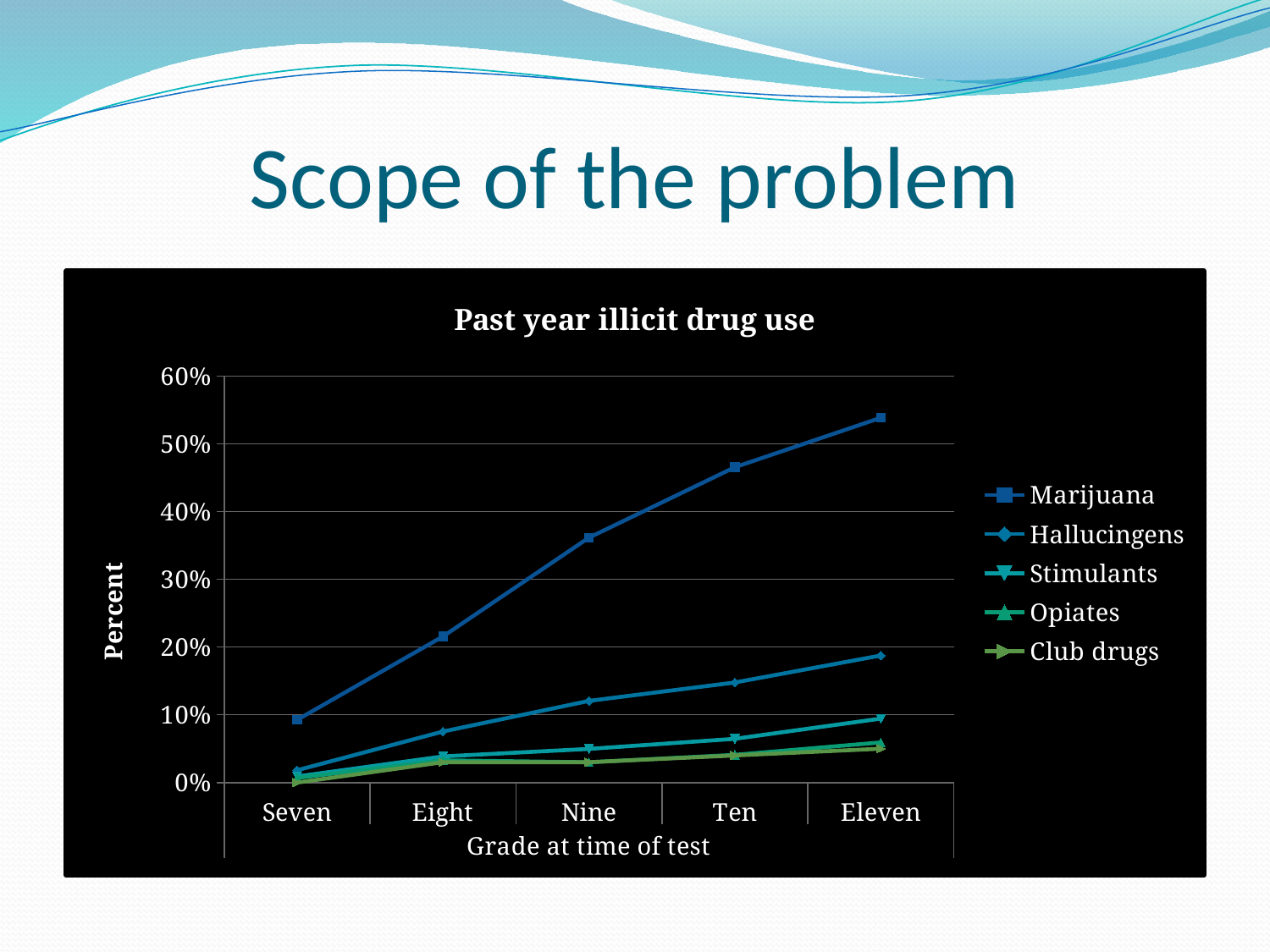
What kind of chart is shown on the slide? line chart How many series does the legend list? 5 What is the title of the chart? Past year illicit drug use Is the value for Marijuana at grade Eleven greater or less than 50%? greater Which series has the highest value at grade Eleven? Marijuana Is the value for Hallucingens at grade Ten greater or less than 10%? greater How many grade categories are shown on the x axis? 5 Is the value for Marijuana at grade Nine greater or less than 30%? greater Does the Marijuana line rise or fall from grade Seven to grade Eleven? rise Which is larger at grade Ten, Hallucingens or Stimulants? Hallucingens